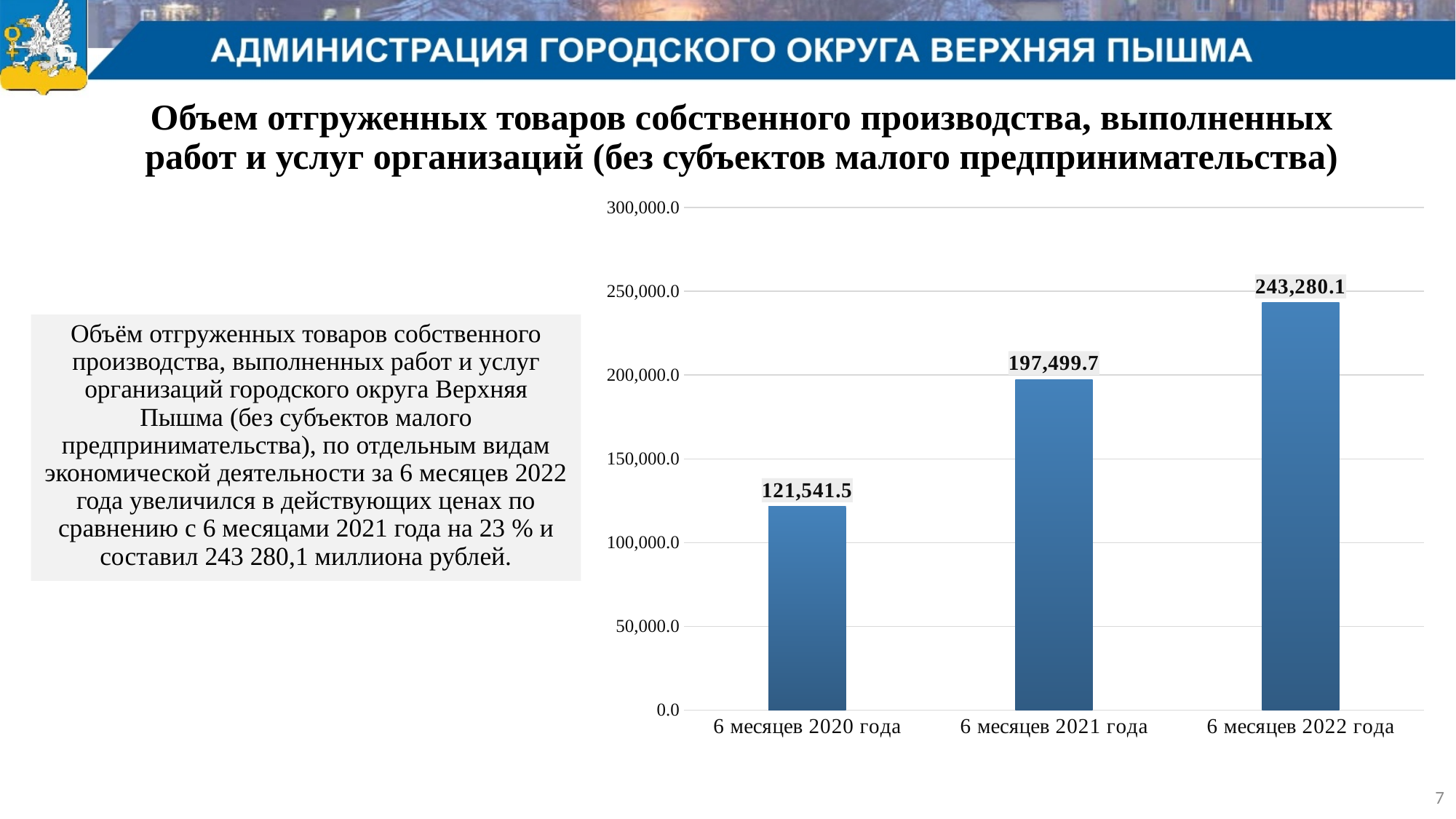
What is the difference between the values for 6 месяцев 2022 года and 6 месяцев 2021 года? 45,780.4 What kind of chart is shown on the slide? bar chart Which period has the highest value? 6 месяцев 2022 года What is the value for 6 месяцев 2021 года? 197,499.7 Is the value for 6 месяцев 2021 года greater or less than 200,000.0? less What is the difference between the values for 6 месяцев 2021 года and 6 месяцев 2020 года? 75,958.2 What is the value for 6 месяцев 2022 года? 243,280.1 How many periods are shown on the x axis? 3 Do the values rise or fall from 6 месяцев 2020 года to 6 месяцев 2022 года? rise Which period has the lowest value? 6 месяцев 2020 года Which is larger, the value for 6 месяцев 2021 года or for 6 месяцев 2020 года? 6 месяцев 2021 года What is the value for 6 месяцев 2020 года? 121,541.5